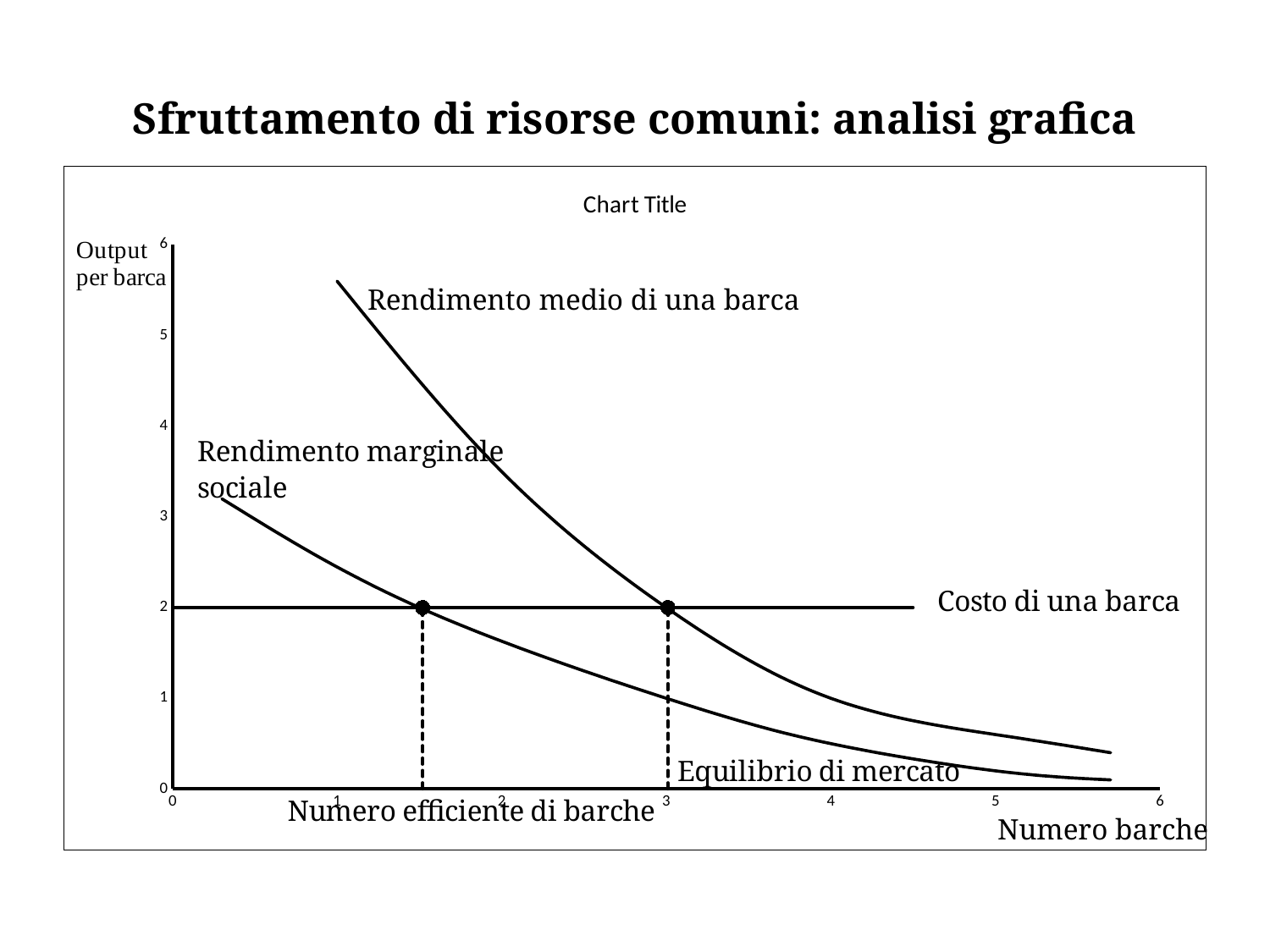
Does the 'Rendimento medio di una barca' curve rise or fall as the number of boats increases? fall Is the value of 'Rendimento marginale sociale' at 4 boats greater or less than 1? less What is the title printed above the chart? Chart Title At what level of output per barca is the horizontal line 'Costo di una barca' drawn? 2 At what number of boats does the 'Equilibrio di mercato' occur? 3 Does the 'Rendimento marginale sociale' curve rise or fall as the number of boats increases? fall At 2 boats, which curve is higher: 'Rendimento medio di una barca' or 'Rendimento marginale sociale'? Rendimento medio di una barca Is the value of 'Rendimento medio di una barca' at 2 boats greater or less than 3? greater What is the label of the horizontal axis? Numero barche How many curves or lines are plotted on the chart? 3 What kind of chart is shown on the slide? line chart Is the 'Numero efficiente di barche' greater or less than 2? less